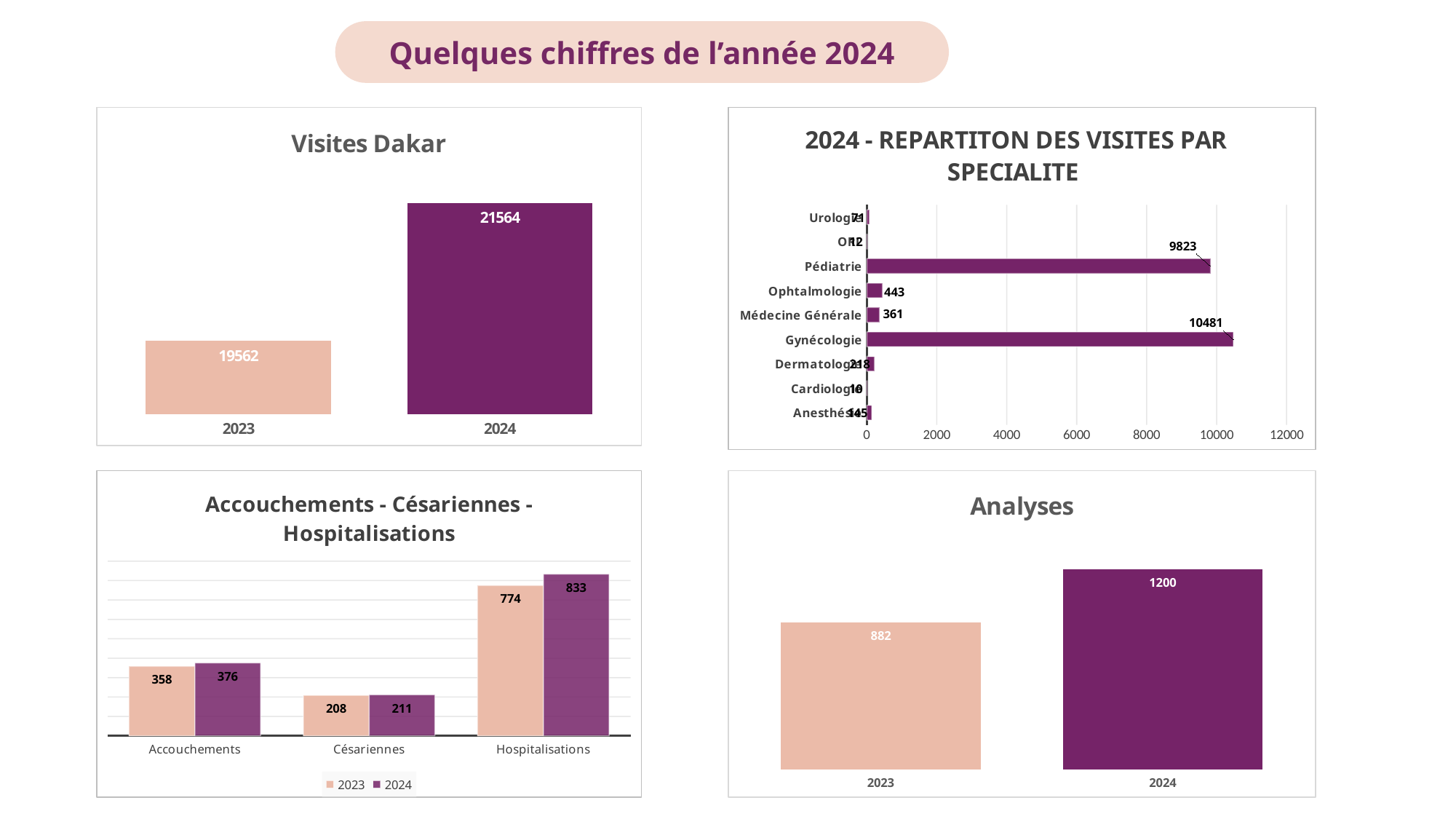
In the 'Accouchements - Césariennes - Hospitalisations' chart, how many series does the legend list? 2 In the 'Analyses' chart, what is the value for 2023? 882 What kind of chart is the '2024 - REPARTITON DES VISITES PAR SPECIALITE' chart? bar chart In the 'Accouchements - Césariennes - Hospitalisations' chart, what is the 2024 value for Hospitalisations? 833 In the '2024 - REPARTITON DES VISITES PAR SPECIALITE' chart, what is the value for Pédiatrie? 9823 In the 'Visites Dakar' chart, what is the difference between the 2024 and 2023 values? 2002 In the 'Visites Dakar' chart, what is the value for 2024? 21564 In the 'Analyses' chart, what is the difference between the 2024 and 2023 values? 318 In the '2024 - REPARTITON DES VISITES PAR SPECIALITE' chart, what is the value for Ophtalmologie? 443 In the '2024 - REPARTITON DES VISITES PAR SPECIALITE' chart, is the value for Gynécologie greater or less than 10000? greater In the '2024 - REPARTITON DES VISITES PAR SPECIALITE' chart, which specialty has the highest value? Gynécologie In the 'Accouchements - Césariennes - Hospitalisations' chart, which is larger: the 2023 value for Césariennes or the 2023 value for Accouchements? Accouchements